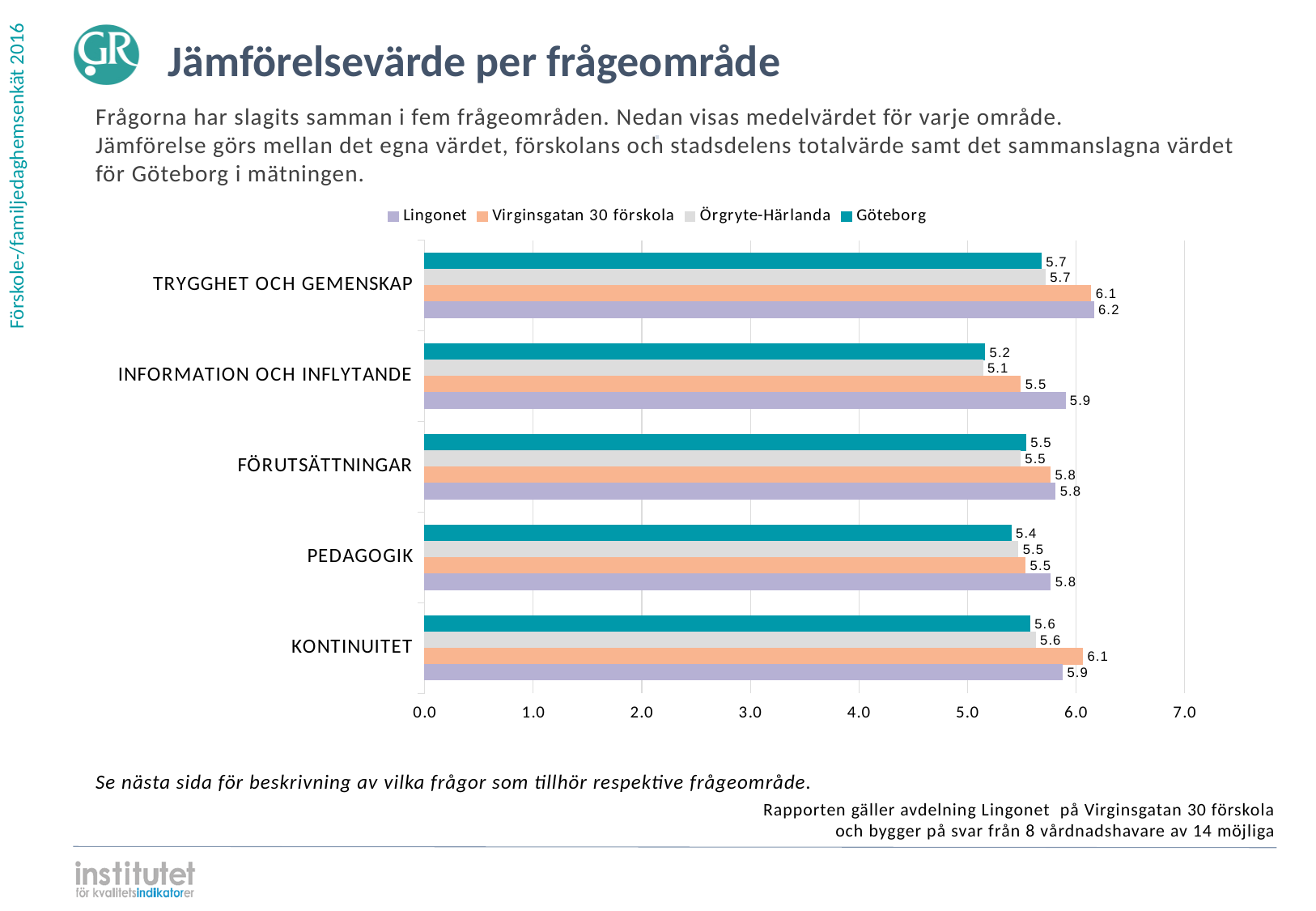
How many series does the legend list? 4 What is the value for Örgryte-Härlanda in PEDAGOGIK? 5.5 What is the value for Lingonet in TRYGGHET OCH GEMENSKAP? 6.2 Is the value for Lingonet in TRYGGHET OCH GEMENSKAP greater or less than 6.0? greater In which category does Lingonet have its highest value? TRYGGHET OCH GEMENSKAP What is the difference between Lingonet and Göteborg in INFORMATION OCH INFLYTANDE? 0.7 Which is larger in KONTINUITET: Lingonet or Virginsgatan 30 förskola? Virginsgatan 30 förskola What is the value for Virginsgatan 30 förskola in KONTINUITET? 6.1 What is the value for Göteborg in INFORMATION OCH INFLYTANDE? 5.2 What kind of chart is shown on the slide? Bar chart How many categories (frågeområden) are shown on the chart? 5 In which category does Örgryte-Härlanda have its lowest value? INFORMATION OCH INFLYTANDE